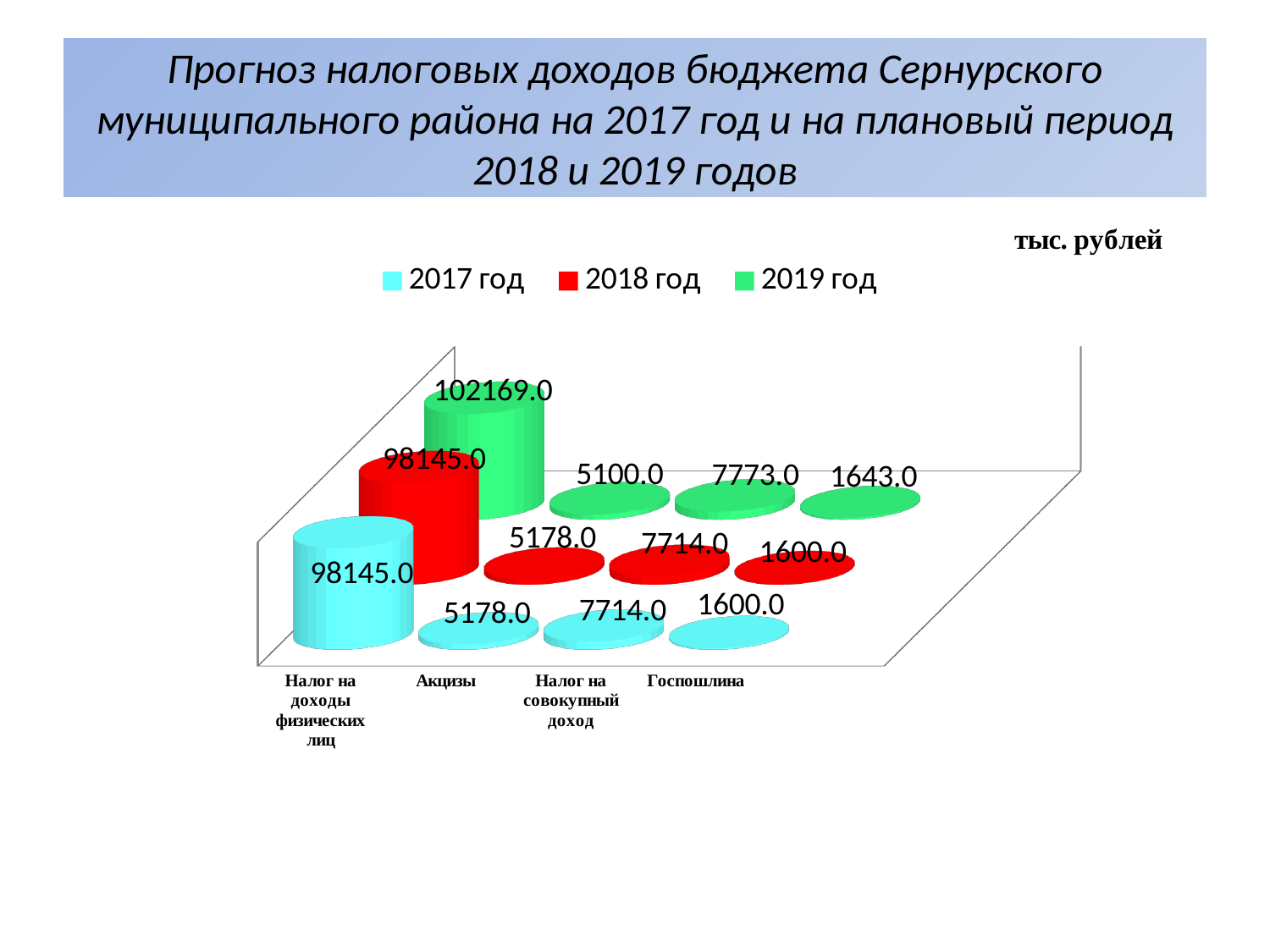
Which is larger for Акцизы: the 2018 год value or the 2019 год value? 2018 год What kind of chart is shown on the slide? bar chart How many categories are shown on the x axis? 4 What is the value for Налог на совокупный доход in the 2018 год series? 7714.0 What is the difference between the 2019 год and 2018 год values for Налог на доходы физических лиц? 4024.0 What is the value for Госпошлина in the 2019 год series? 1643.0 What unit is stated above the chart? тыс. рублей What is the value for Налог на доходы физических лиц in the 2019 год series? 102169.0 Which category has the lowest value in the 2019 год series? Госпошлина How many series does the legend list? 3 Which category has the highest value in the 2017 год series? Налог на доходы физических лиц What is the value for Акцизы in the 2017 год series? 5178.0